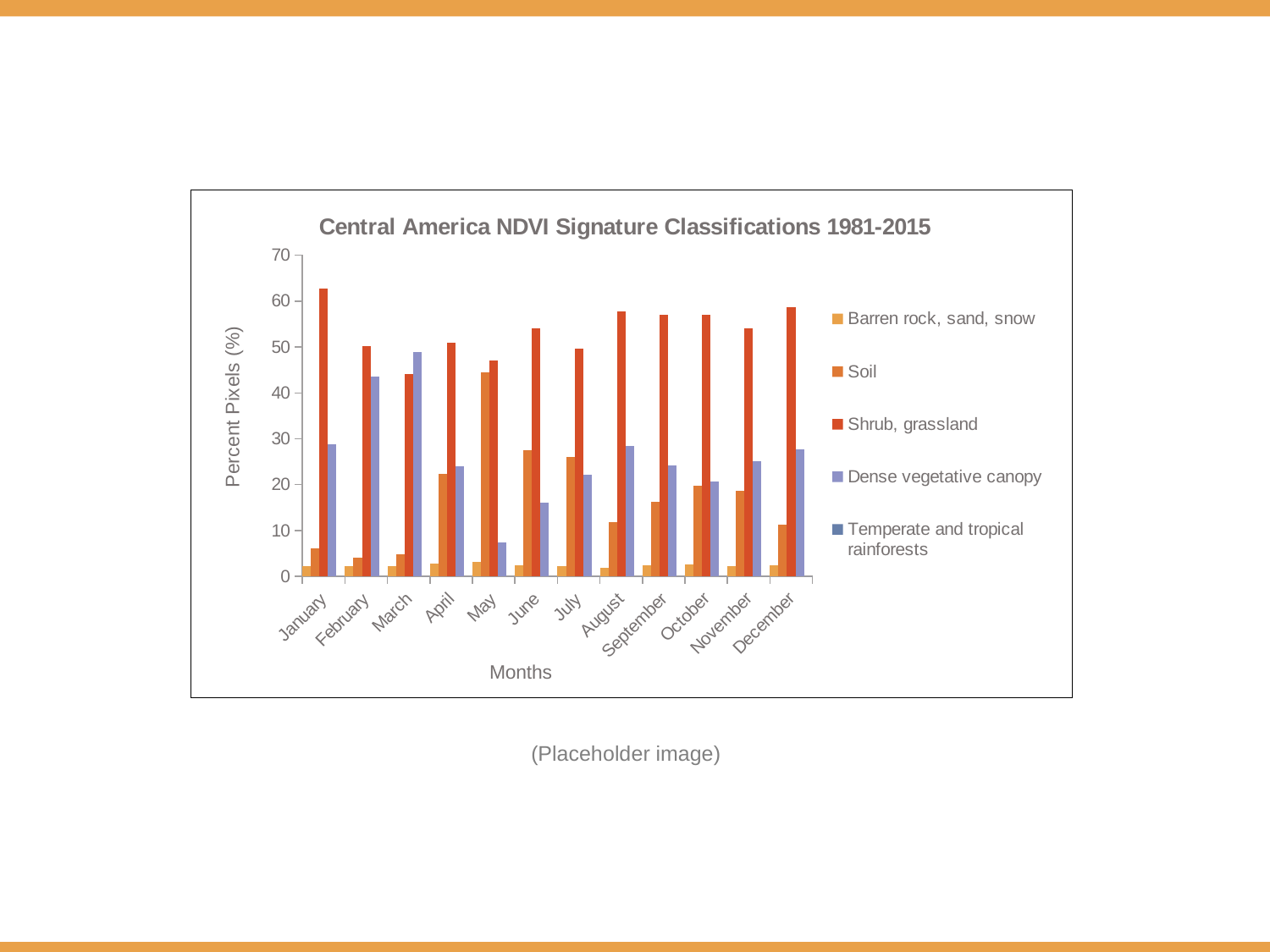
How many months are shown along the x axis? 12 What is the title of the chart? Central America NDVI Signature Classifications 1981-2015 Is the Soil value for May greater or less than 40? greater Is the Shrub, grassland value for January greater or less than 60? greater What kind of chart is shown on the slide? bar chart What is the label of the vertical axis? Percent Pixels (%) In March, which is larger: the Soil value or the Dense vegetative canopy value? Dense vegetative canopy In which month is the Soil value lowest? February How many series does the legend list? 5 Is the Dense vegetative canopy value for May greater or less than 10? less In which month is the Shrub, grassland value highest? January In which month is the Dense vegetative canopy value highest? March